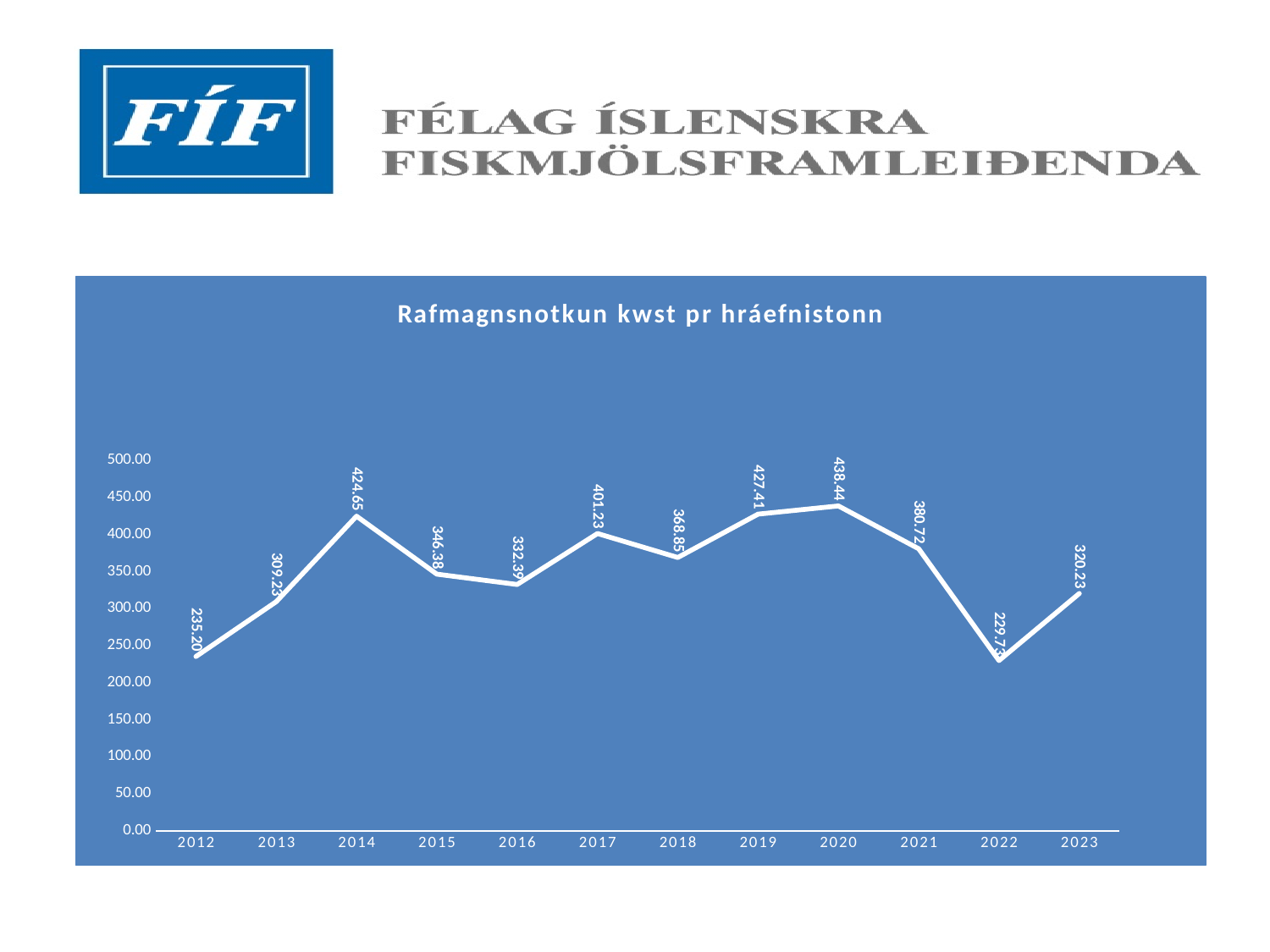
What is the value for 2014 in the chart? 424.65 What is the difference between the values for 2014 and 2013? 115.42 What kind of chart is shown on the slide? line chart How many years are plotted on the x axis? 12 Which year has the highest value in the chart? 2020 Is the value for 2012 greater or less than 250.00? less Which is larger, the value for 2017 or the value for 2018? 2017 What is the title of the chart? Rafmagnsnotkun kwst pr hráefnistonn What is the value for 2012 in the chart? 235.20 What is the value for 2023 in the chart? 320.23 What is the value for 2020 in the chart? 438.44 What is the difference between the values for 2021 and 2023? 60.49